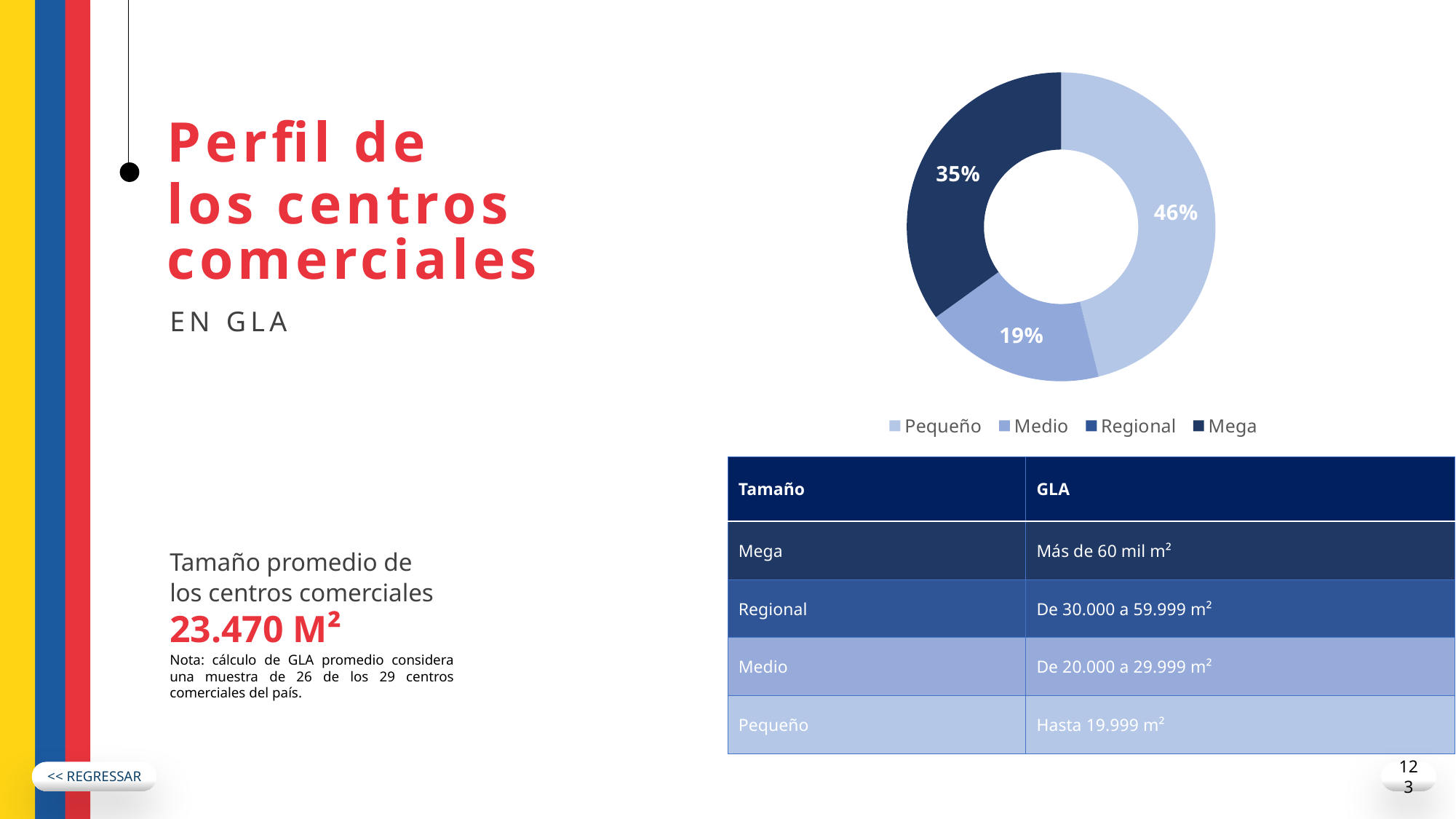
What percentage is shown for the Medio slice in the pie chart? 19% What is the combined share of the Pequeño, Medio and Mega slices in the pie chart? 100% Which category has the largest slice in the pie chart? Pequeño What is the difference in percentage points between the Pequeño slice and the Mega slice? 11 percentage points What is the difference in percentage points between the Pequeño slice and the Medio slice? 27 percentage points Which slice is larger in the pie chart, Mega or Medio? Mega What type of chart is shown on the slide? Pie chart (doughnut) Which of the labelled slices in the pie chart is the smallest? Medio What are the legend entries of the pie chart, in order? Pequeño, Medio, Regional, Mega What percentage of the pie chart does the Pequeño slice represent? 46% How many categories does the legend of the pie chart list? 4 What percentage is shown for the Mega slice in the pie chart? 35%